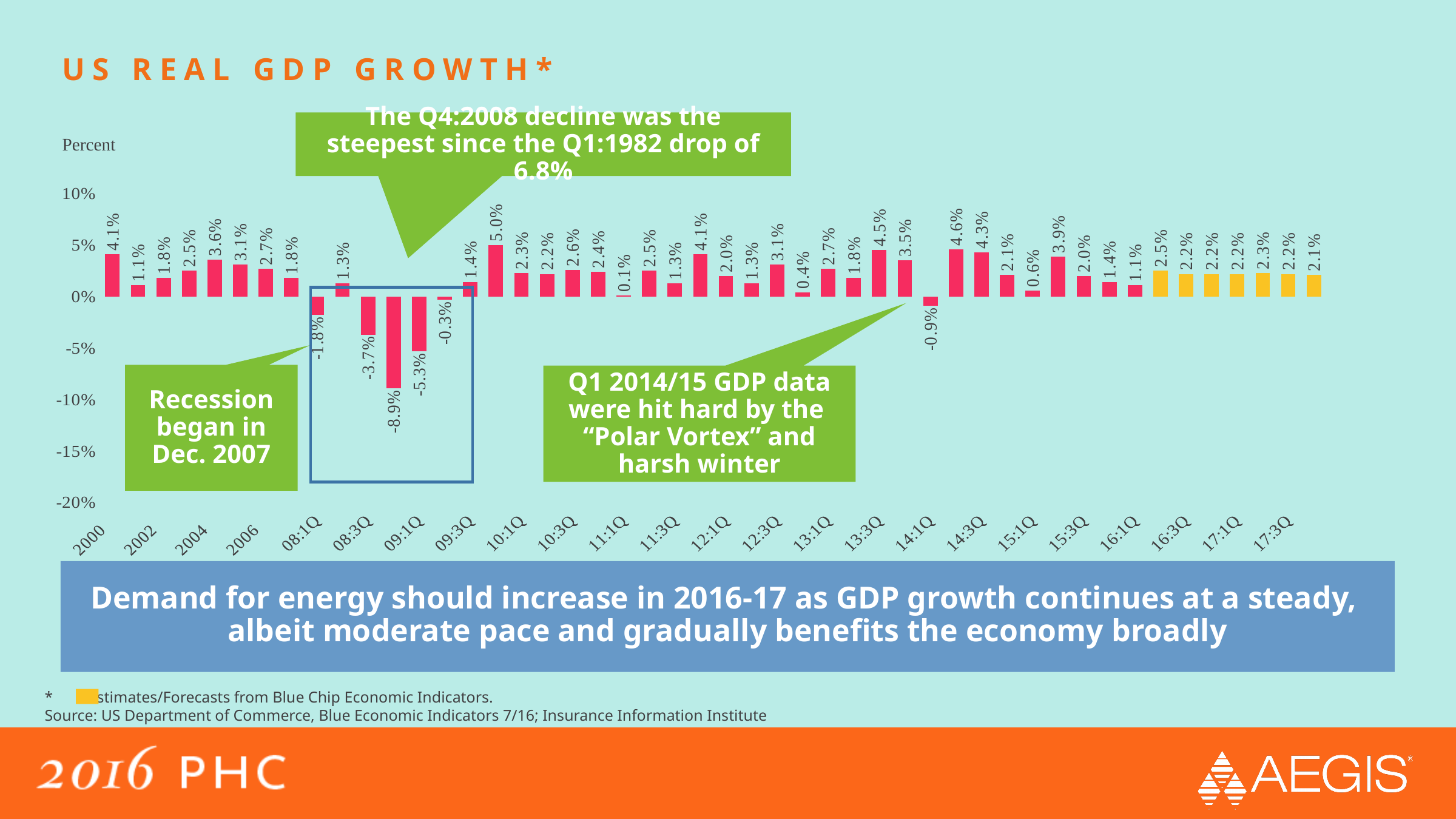
What is the lowest value plotted on the chart? -8.9% What is the value shown for 15:1Q? 0.6% By how many percentage points does the 2004 value exceed the 2006 value? 0.9 percentage points What is the value shown for 08:1Q? -1.8% What kind of chart is shown on the slide? Bar chart What is the value shown for 14:1Q? -0.9% What is the title of the chart? US REAL GDP GROWTH* Is the value for 08:3Q greater or less than -5%? greater Which is larger, the value for 2000 or the value for 2002? 2000 What is the highest value plotted on the chart? 5.0% What is the value shown for 17:3Q? 2.2% What is the US real GDP growth value for 2000? 4.1%